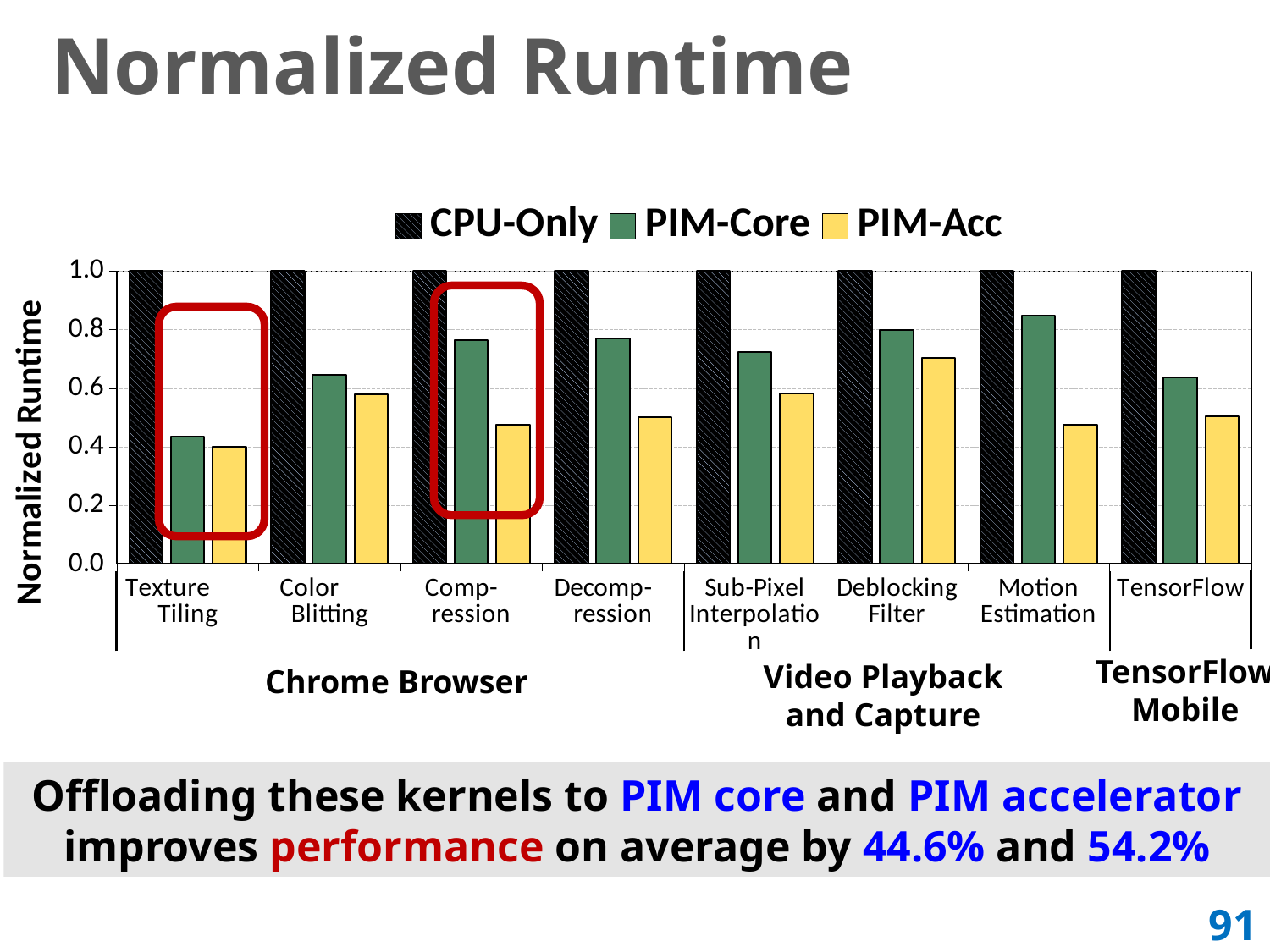
Is the PIM-Core value for Texture Tiling greater or less than 0.6? less Is the PIM-Acc value for Deblocking Filter greater or less than 0.6? greater How many series does the legend list? 3 For Motion Estimation, which is larger: the PIM-Core value or the PIM-Acc value? PIM-Core Which application group contains the Texture Tiling, Color Blitting, Compression and Decompression kernels? Chrome Browser How many kernel categories are plotted along the x axis? 8 What is the CPU-Only normalized runtime for Texture Tiling? 1.0 Is the PIM-Core value for Compression greater or less than 0.6? greater What kind of chart is shown on the slide? bar chart Which kernel has the lowest PIM-Acc normalized runtime? Texture Tiling Which kernel has the highest PIM-Core normalized runtime? Motion Estimation What are the three series named in the legend? CPU-Only, PIM-Core, PIM-Acc